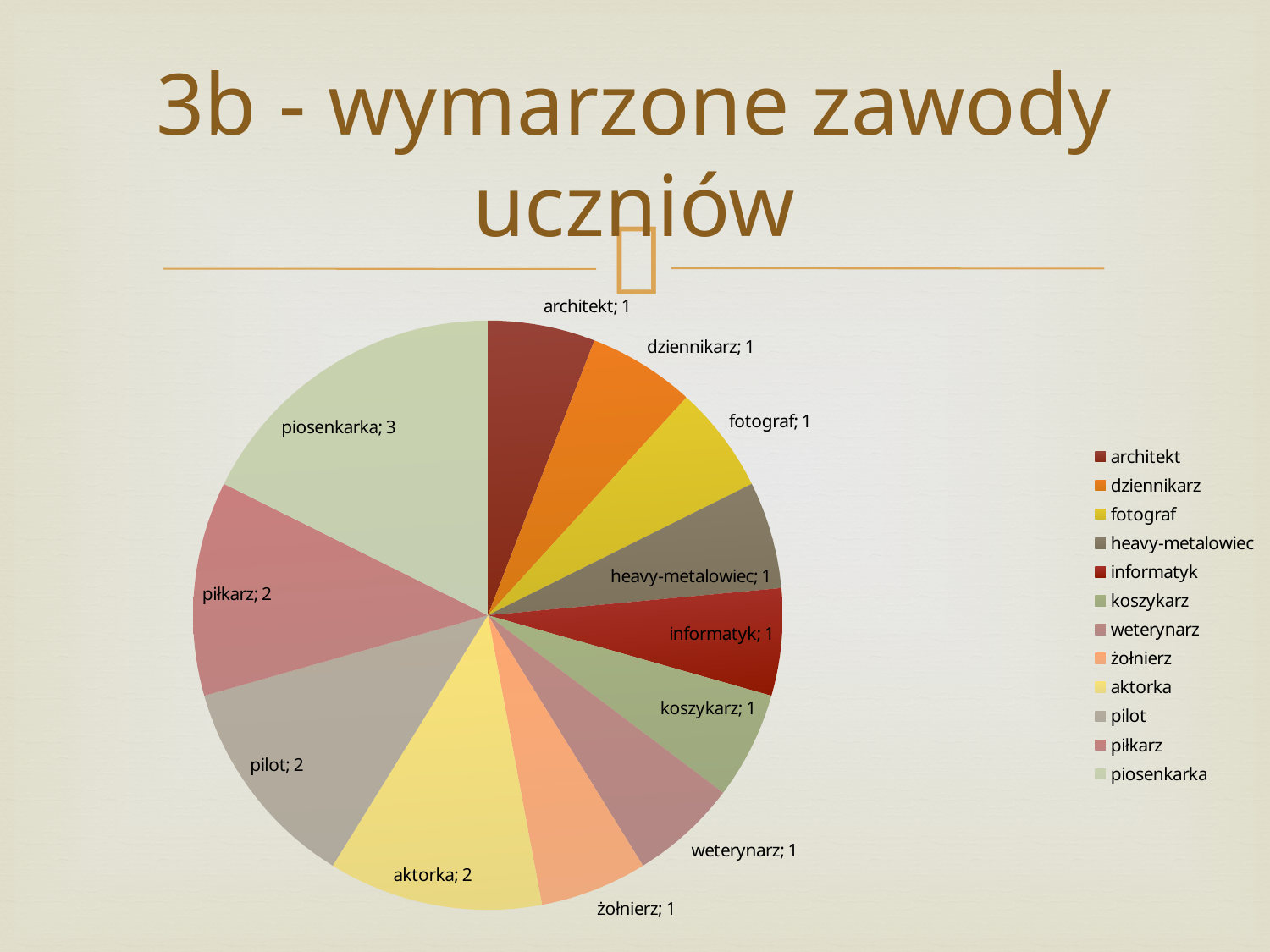
How many categories (slices) does the pie chart have? 12 What kind of chart is shown on the slide? pie chart What is the difference between the values for piosenkarka and aktorka? 1 Which is larger, the value for piosenkarka or the value for piłkarz? piosenkarka What is the difference between the values for piłkarz and żołnierz? 1 What is the title of the slide containing the chart? 3b - wymarzone zawody uczniów What is the value for pilot in the pie chart? 2 Which is larger, the value for pilot or the value for fotograf? pilot Which category has the largest slice in the pie chart? piosenkarka How many entries does the legend list? 12 What is the value for informatyk in the pie chart? 1 What is the value for piosenkarka in the pie chart? 3